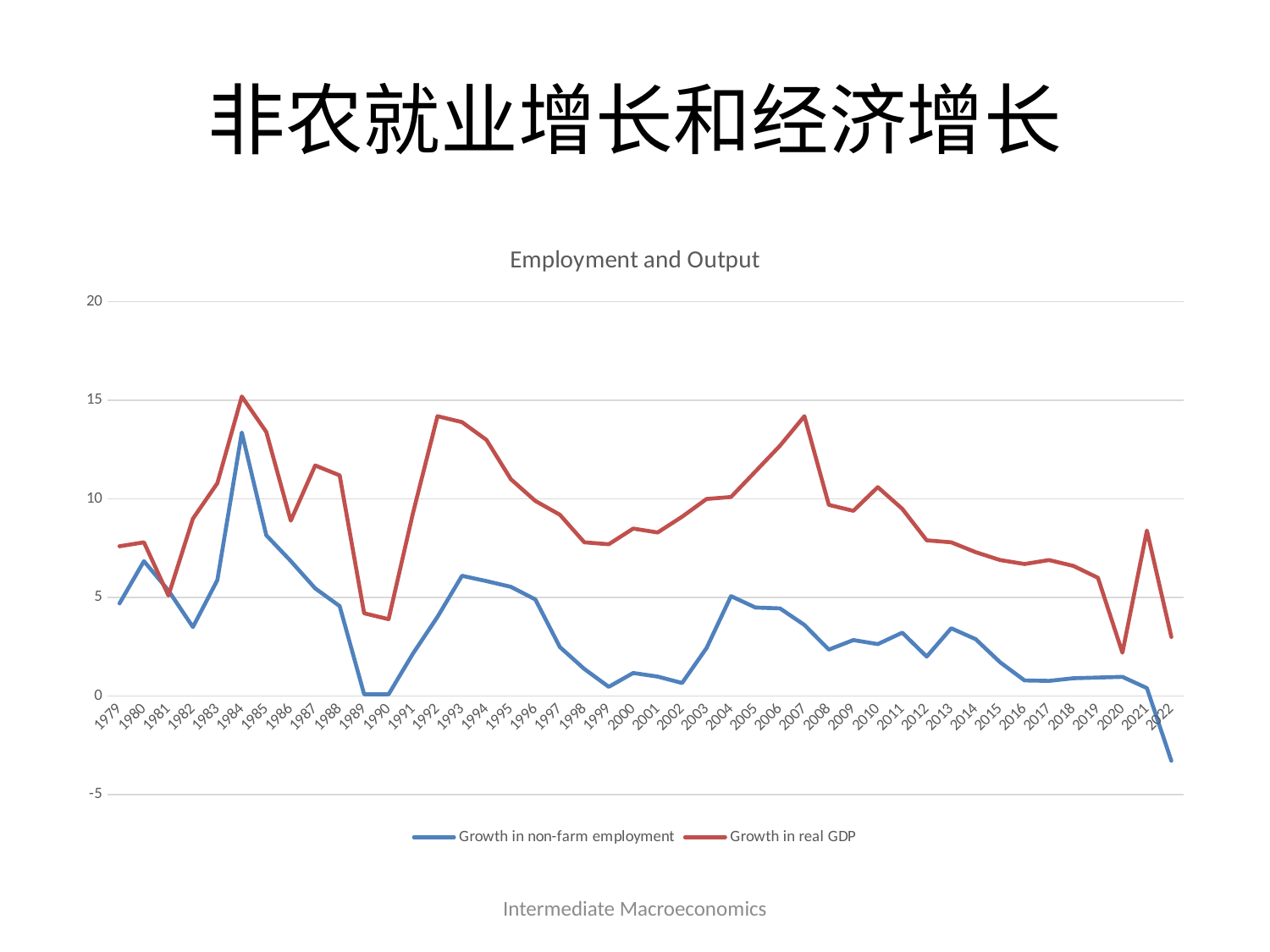
Is the value for Growth in real GDP in 1992 greater or less than 10? greater In which year is Growth in real GDP highest? 1984 How many years are plotted along the x axis? 44 How many series does the legend list? 2 Which series is drawn in red? Growth in real GDP Which is larger in 2007, Growth in real GDP or Growth in non-farm employment? Growth in real GDP Is the value for Growth in non-farm employment in 2022 greater or less than 0? less In which year is Growth in non-farm employment lowest? 2022 What is the title of the chart? Employment and Output What kind of chart is shown on the slide? line chart In which year is Growth in non-farm employment highest? 1984 Does Growth in non-farm employment rise or fall from 2019 to 2022? fall